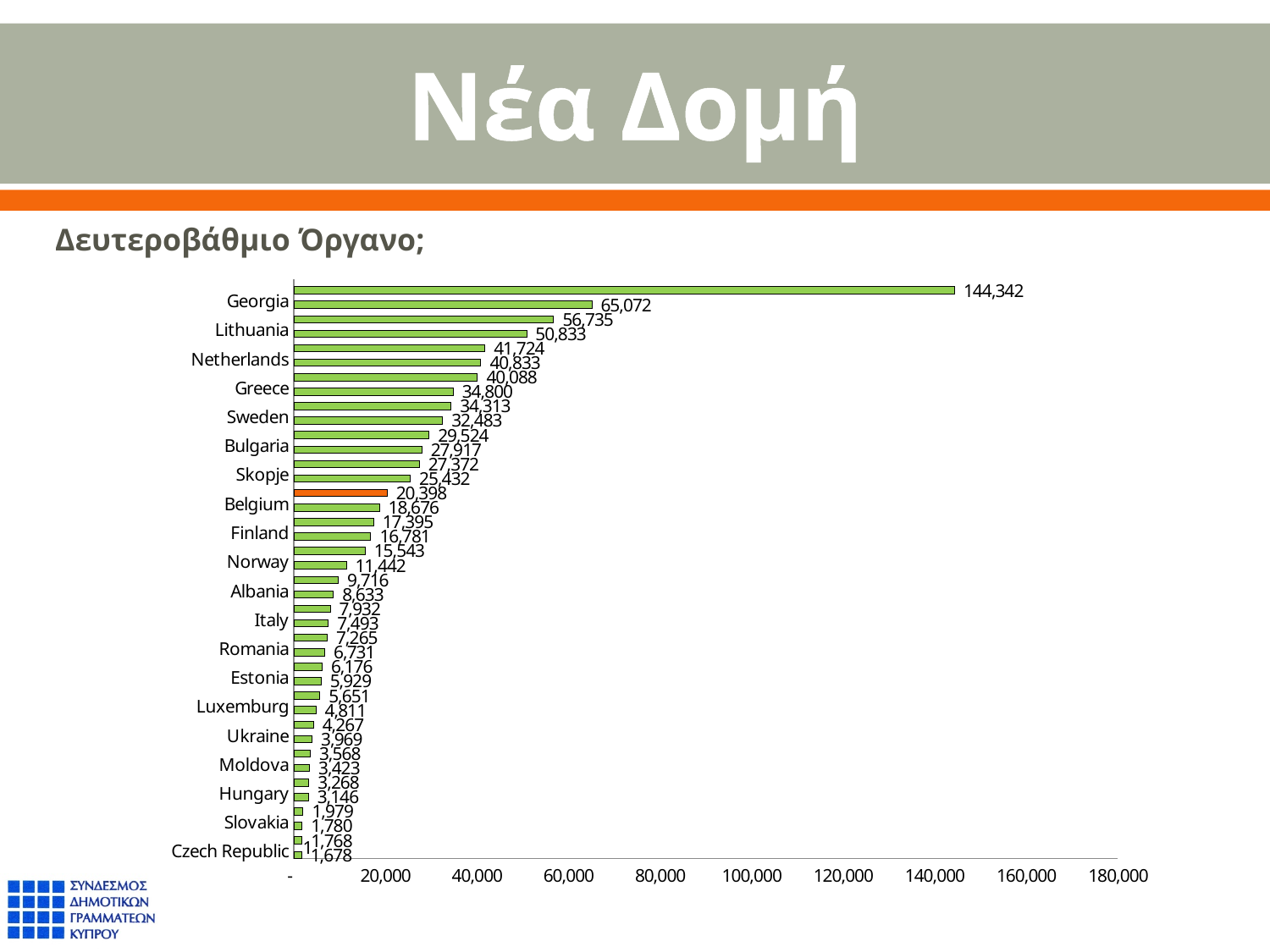
What is the largest value labelled on the chart? 144,342 What is the difference between the largest value (144,342) and the smallest value (1,678) on the chart? 142,664 What value is labelled on the single orange bar? 20,398 What is the value for Czech Republic? 1,678 What type of chart is shown on the slide? bar chart Is the value for Czech Republic greater or less than 20,000? less Which has the larger value, Georgia or Czech Republic? Georgia How many bars are plotted on the chart? 40 Which has the larger value, Netherlands or Hungary? Netherlands What is the highest tick value shown on the horizontal axis? 180,000 Which country has the lowest value on the chart? Czech Republic Do the bar values increase or decrease going from the top of the chart to the bottom? decrease